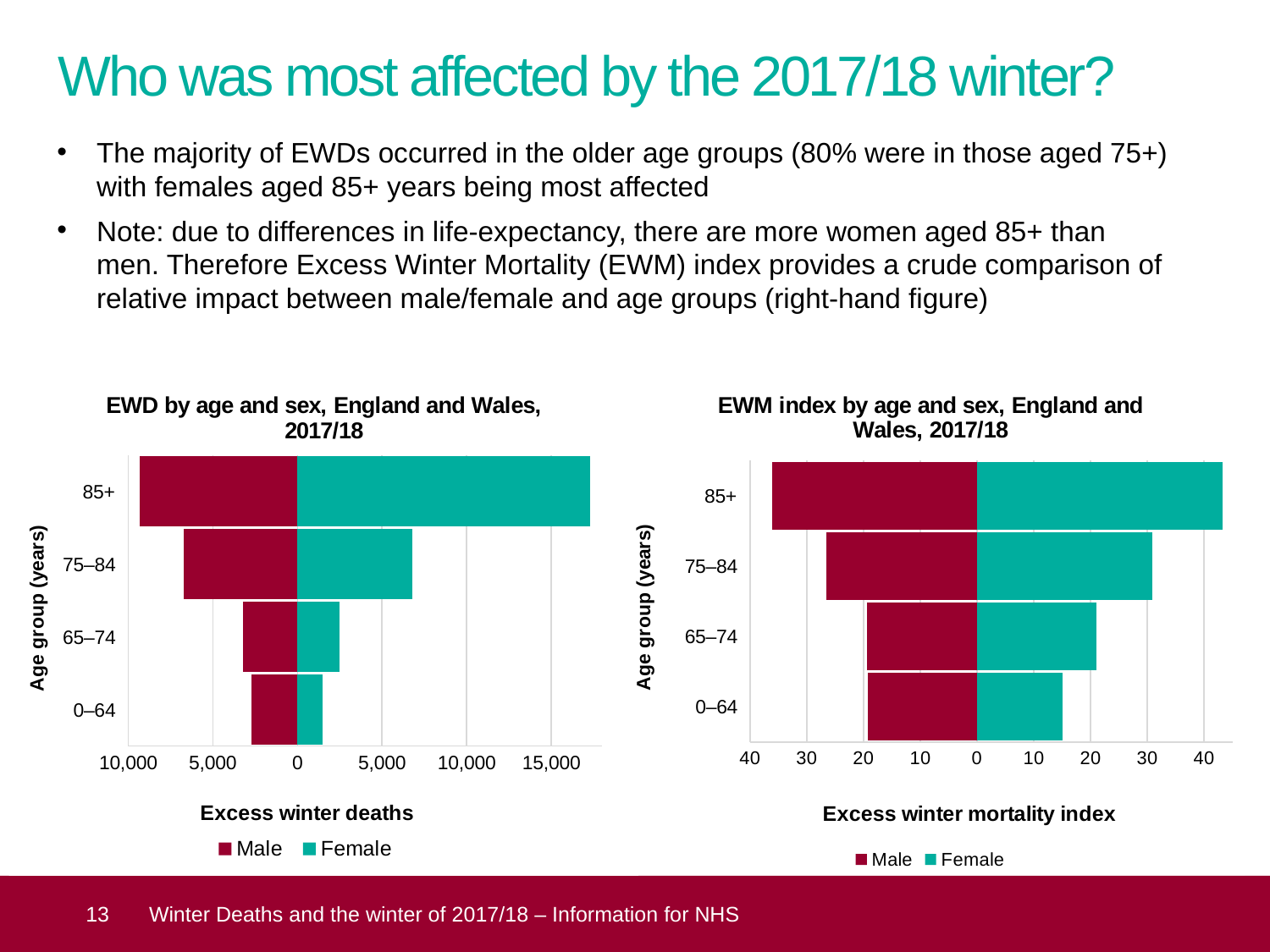
In the right-hand chart 'EWM index by age and sex', is the Male value for 85+ greater or less than 30? greater In the left-hand chart 'EWD by age and sex', how many age groups are shown on the y axis? 4 What kind of chart is the left-hand chart, 'EWD by age and sex, England and Wales, 2017/18'? Bar chart In the right-hand chart 'EWM index by age and sex', is the Female value for 0–64 greater or less than 20? less In the left-hand chart 'EWD by age and sex', how many series does the legend list? 2 In the left-hand chart 'EWD by age and sex', is the Female value for 85+ greater or less than 15,000? greater In the right-hand chart 'EWM index by age and sex', which age group has the lowest Female value? 0–64 In the left-hand chart 'EWD by age and sex', which is larger for the 85+ age group, the Male or the Female value? Female In the left-hand chart 'EWD by age and sex', which age group has the highest Female value? 85+